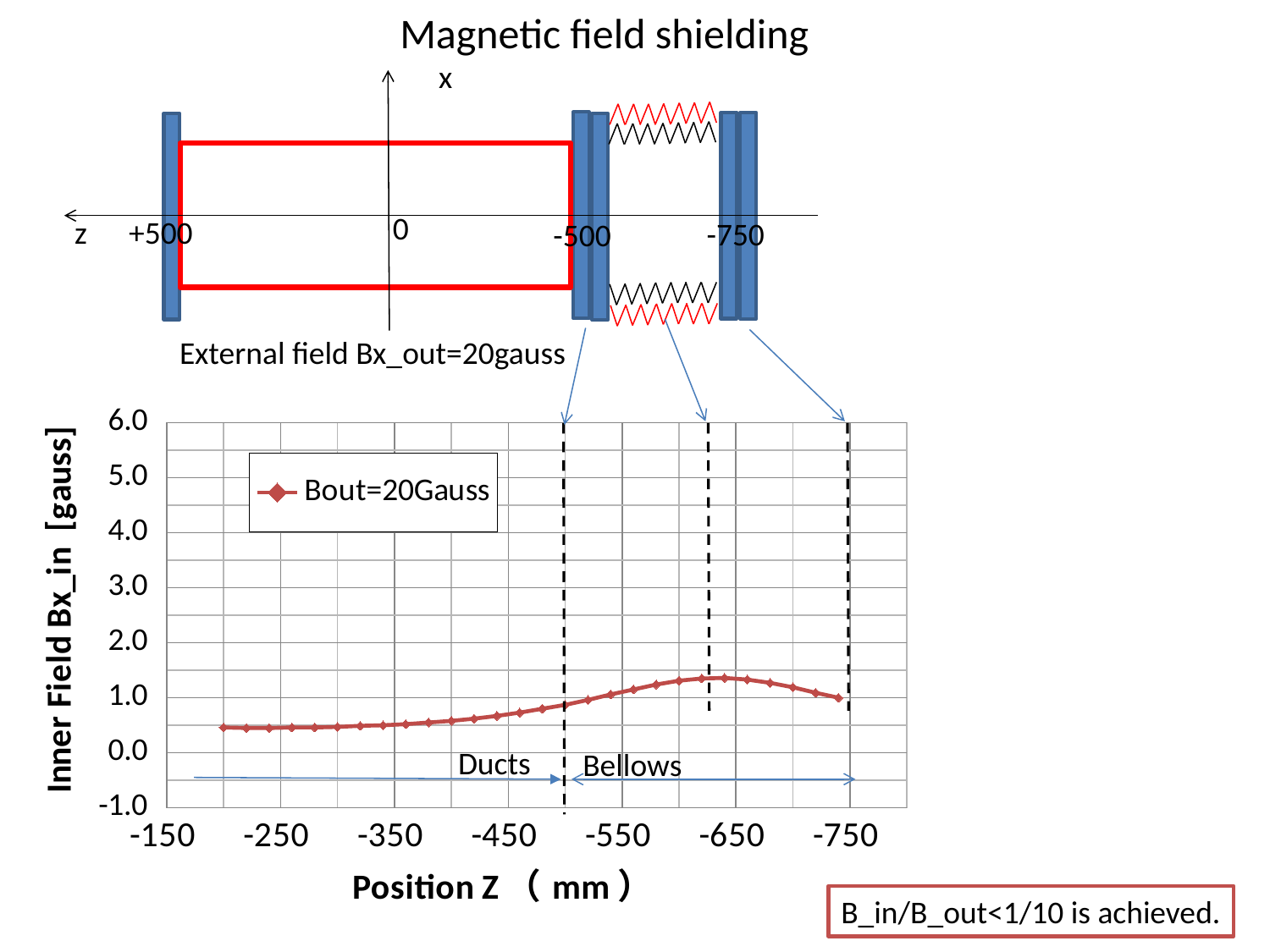
Is the inner field value at Position Z = -250 mm greater or less than 1.0? less Which has the larger inner field value: Position Z = -650 mm or Position Z = -250 mm? -650 mm Does the inner field rise or fall as Position Z goes from -250 mm to -550 mm? rise What is the title of the chart's vertical axis? Inner Field Bx_in [gauss] How many series does the chart's legend list? 1 What is the name of the series shown in the chart's legend? Bout=20Gauss Does the inner field rise or fall as Position Z goes from -650 mm to -750 mm? fall What kind of chart is shown on the slide? line chart Is the inner field value at Position Z = -750 mm greater or less than 2.0? less Is the inner field value at Position Z = -650 mm greater or less than 1.0? greater